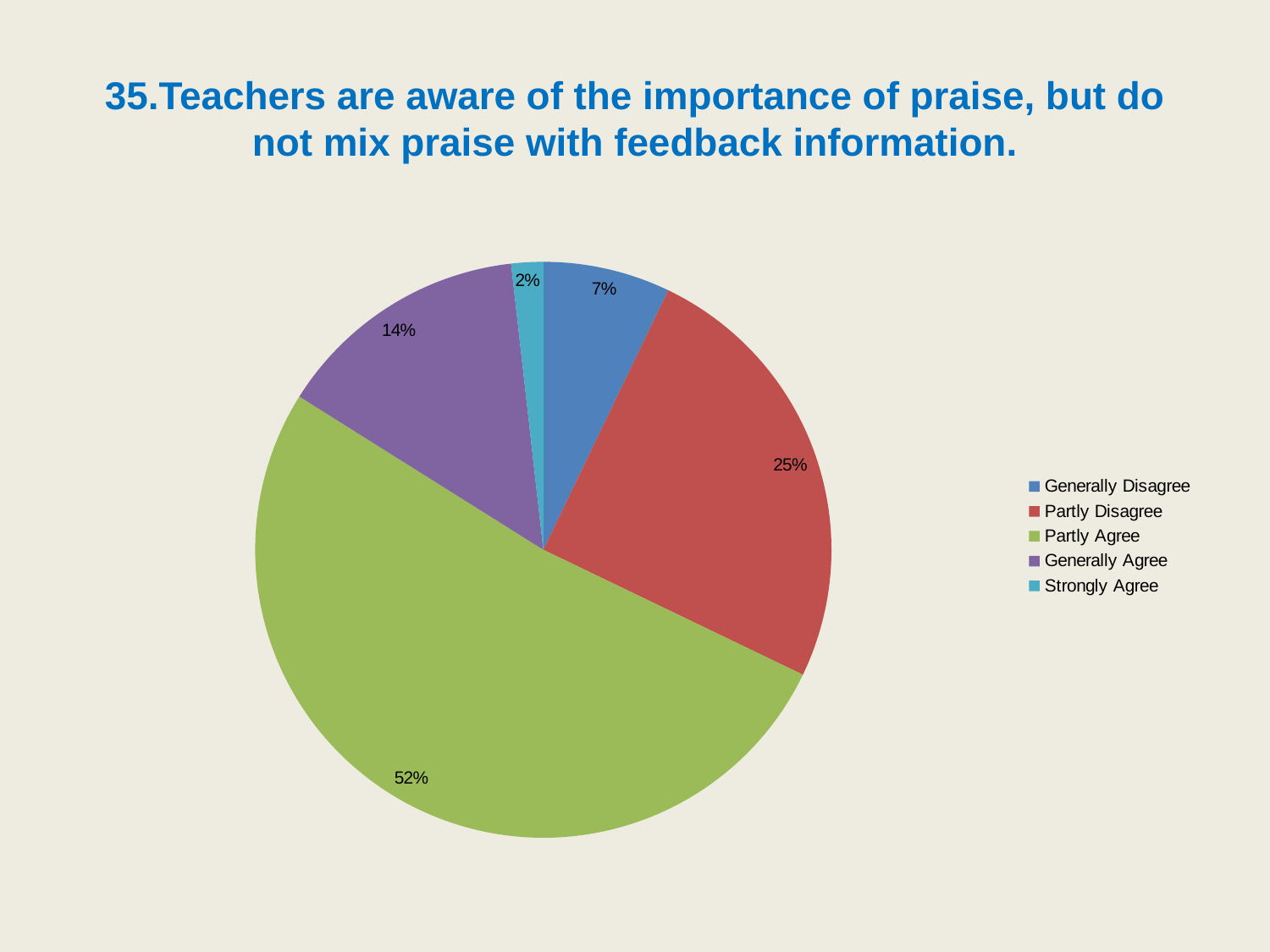
What share of the pie is Generally Agree? 14% Which is larger, the Generally Agree slice or the Generally Disagree slice? Generally Agree What share of the pie is Generally Disagree? 7% What share of the pie is Strongly Agree? 2% Which category has the largest slice of the pie? Partly Agree Which category has the smallest slice of the pie? Strongly Agree What colour is the Partly Agree slice? green What kind of chart is shown on the slide? pie chart What is the difference between the Partly Agree and Partly Disagree shares? 27% How many categories does the legend list? 5